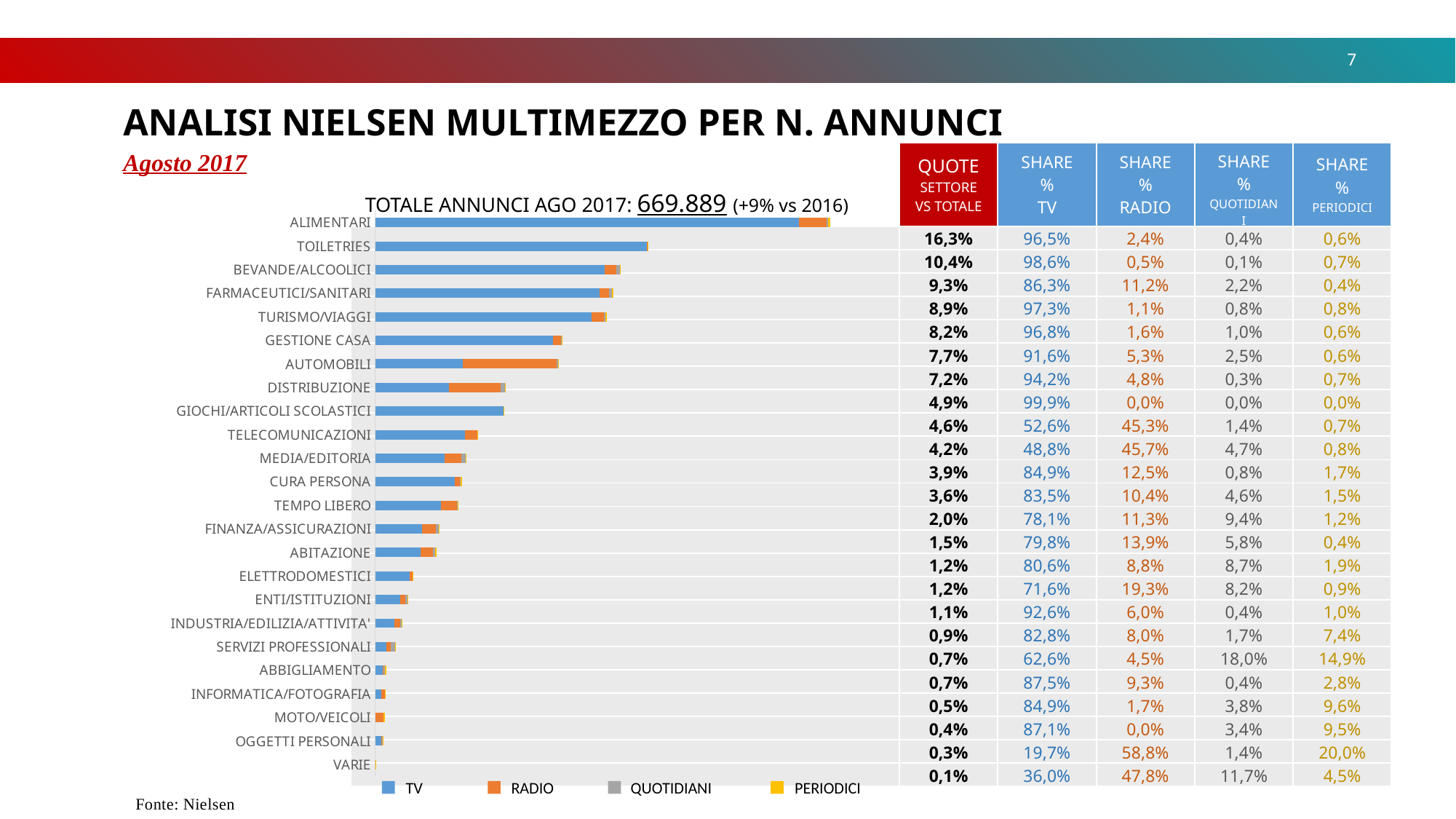
Which category has the shortest bar in the chart? VARIE Do the bar lengths increase or decrease going from the top category to the bottom category? Decrease How many series does the chart legend list? 4 Which bar is longer, TELECOMUNICAZIONI or ABITAZIONE? TELECOMUNICAZIONI What kind of chart is shown on the slide? Stacked bar chart Which bar is longer, TOILETRIES or AUTOMOBILI? TOILETRIES How many categories (sectors) are plotted in the bar chart? 24 Which series is shown in orange in the chart legend? RADIO What total number of announcements for August 2017 is stated in the chart title? 669.889 Which category has the largest RADIO segment in its bar? AUTOMOBILI Which category has the longest bar in the chart? ALIMENTARI Which bar is longer, ALIMENTARI or TOILETRIES? ALIMENTARI